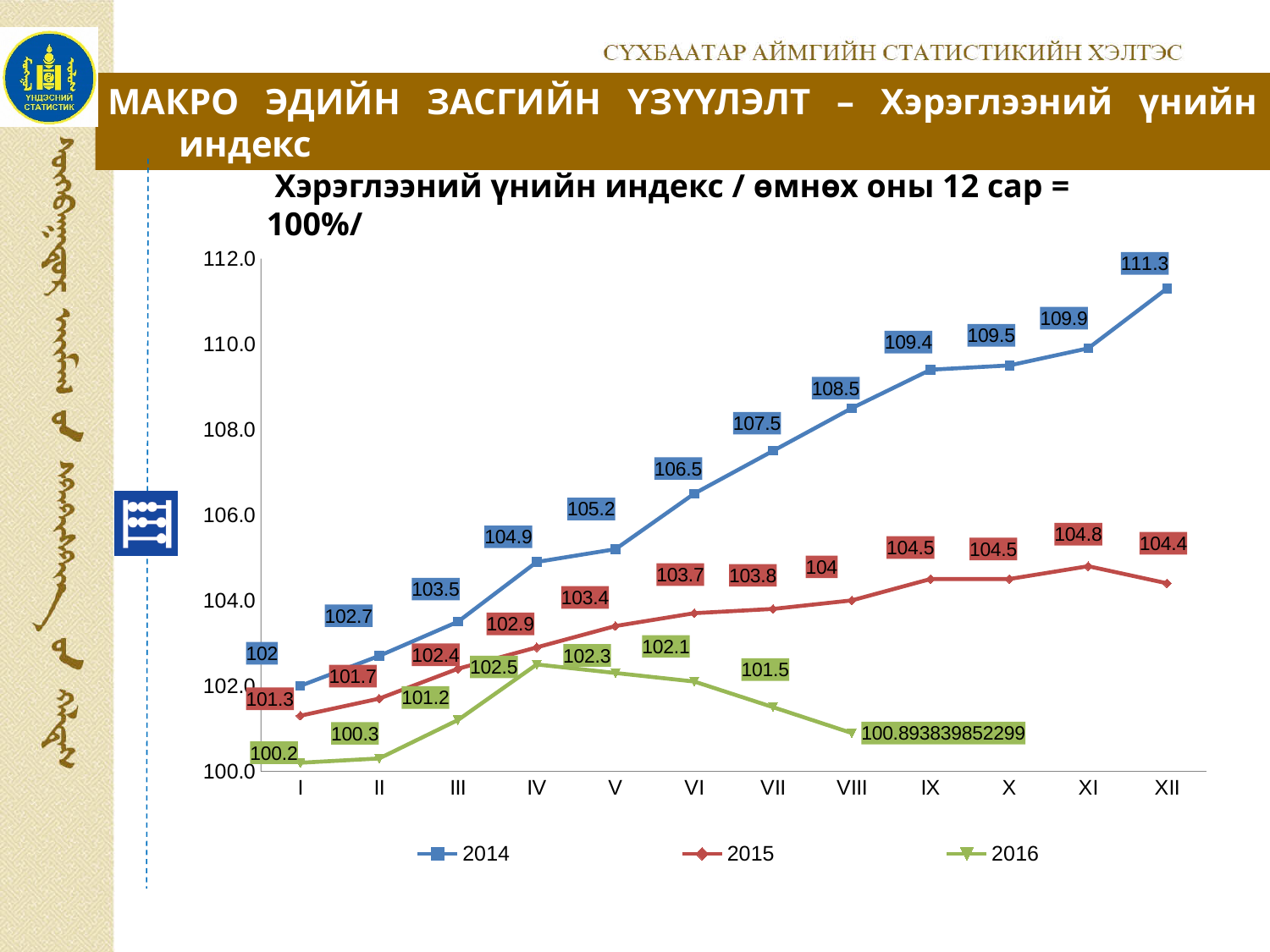
What type of chart is shown on the slide? line chart Which is larger in month VI: the 2014 value or the 2015 value? 2014 What is the value for 2016 in month IV? 102.5 How many series does the legend list? 3 What colour is the line for the 2015 series? red What is the value for 2015 in month VIII? 104 In which month is the 2016 series lowest? I What is the value for 2014 in month XII? 111.3 Does the 2014 series rise or fall from month I to month XII? rise What is the difference between the 2014 value in month XII and the 2014 value in month I? 9.3 In which month does the 2015 series reach its highest value? XI How many months are plotted for the 2016 series? 8